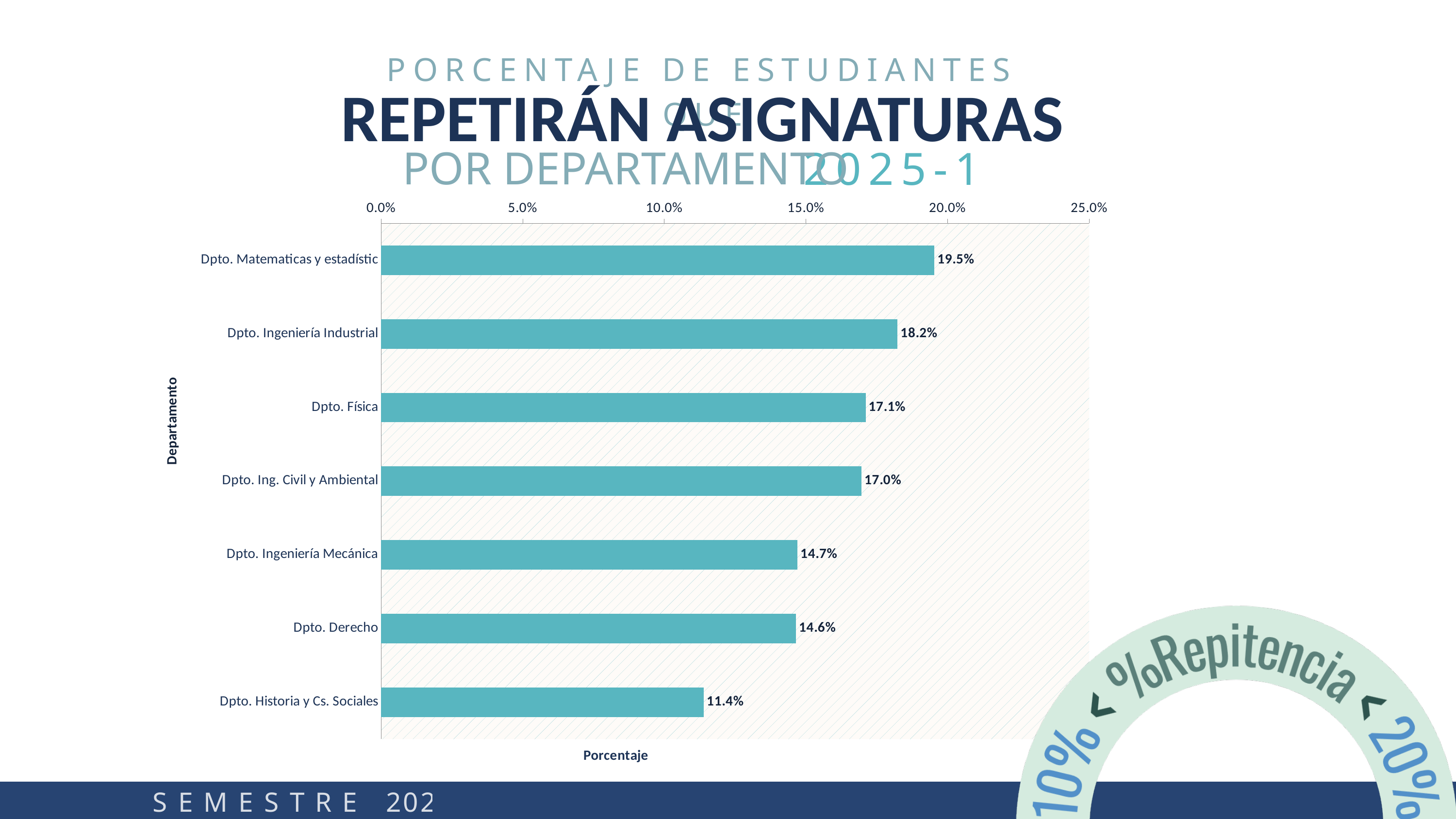
Which department has the highest percentage? Dpto. Matematicas y estadístic What is the value for Dpto. Historia y Cs. Sociales? 11.4% Which department has the lowest percentage? Dpto. Historia y Cs. Sociales What is the difference between the values for Dpto. Matematicas y estadístic and Dpto. Historia y Cs. Sociales? 8.1% What is the difference between the values for Dpto. Ingeniería Industrial and Dpto. Física? 1.1% What is the value for Dpto. Ingeniería Mecánica? 14.7% How many departments are shown in the chart? 7 What is the title of the horizontal axis of the chart? Porcentaje What kind of chart is shown on the slide? bar chart What is the value for Dpto. Ingeniería Industrial? 18.2% Is the value for Dpto. Ing. Civil y Ambiental greater or less than 15.0%? greater Which is larger, the value for Dpto. Derecho or the value for Dpto. Física? Dpto. Física